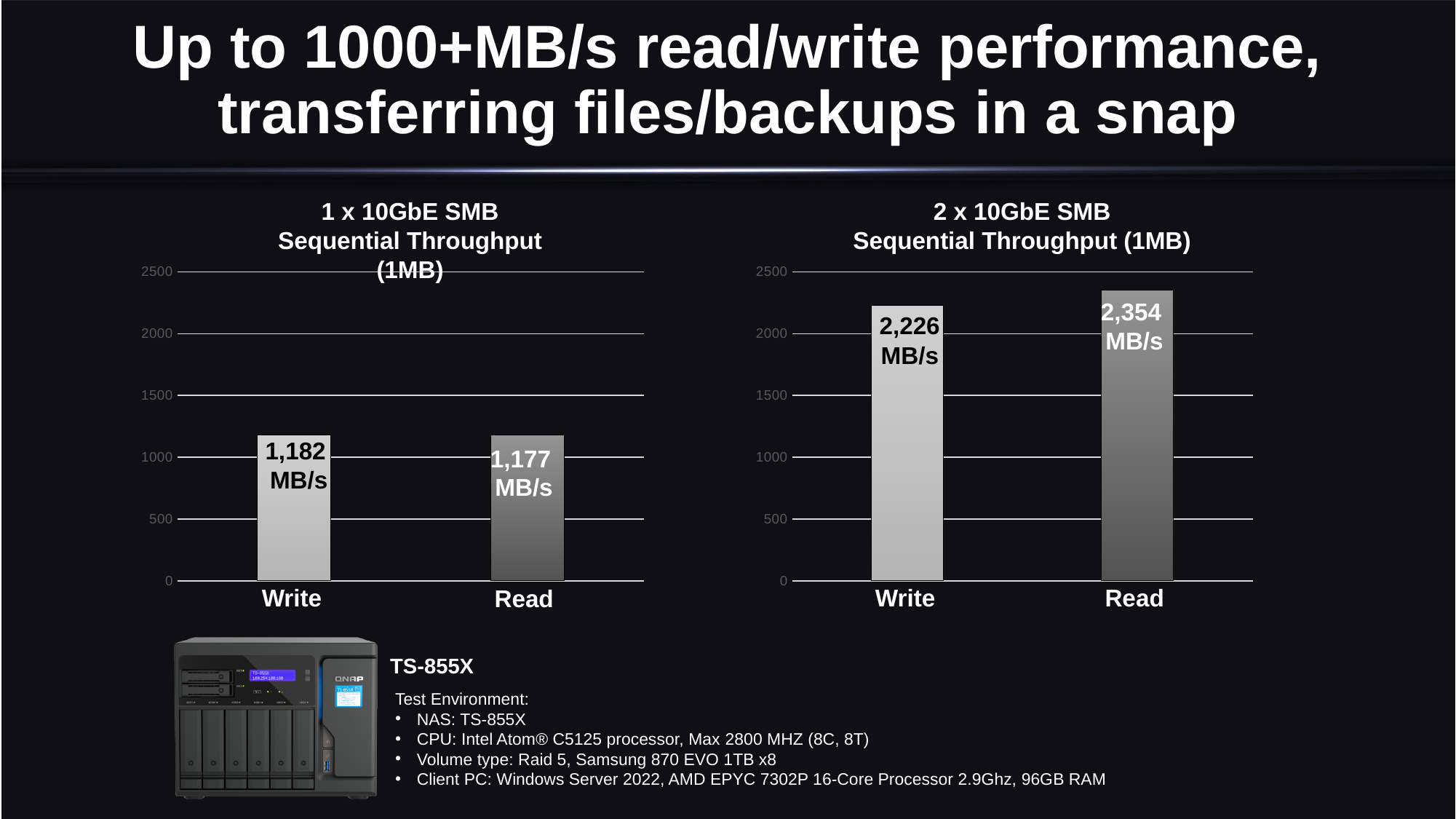
In the 2 x 10GbE SMB Sequential Throughput (1MB) chart, which category has the lowest value? Write What type of chart is the 2 x 10GbE SMB Sequential Throughput (1MB) chart? Bar chart In the 1 x 10GbE SMB Sequential Throughput (1MB) chart, what is the value for Write? 1,182 MB/s In the 1 x 10GbE SMB Sequential Throughput (1MB) chart, what is the value for Read? 1,177 MB/s In the 2 x 10GbE SMB Sequential Throughput (1MB) chart, which category has the highest value? Read How many categories are shown in the 1 x 10GbE SMB Sequential Throughput (1MB) chart? 2 In the 2 x 10GbE SMB Sequential Throughput (1MB) chart, what is the value for Read? 2,354 MB/s In the 1 x 10GbE SMB Sequential Throughput (1MB) chart, is the value for Read greater or less than 1500? less In the 2 x 10GbE SMB Sequential Throughput (1MB) chart, is the value for Write greater or less than 2000? greater In the 1 x 10GbE SMB Sequential Throughput (1MB) chart, what is the difference between the Write and Read values? 5 MB/s In the 2 x 10GbE SMB Sequential Throughput (1MB) chart, what is the value for Write? 2,226 MB/s In the 2 x 10GbE SMB Sequential Throughput (1MB) chart, what is the difference between the Read and Write values? 128 MB/s